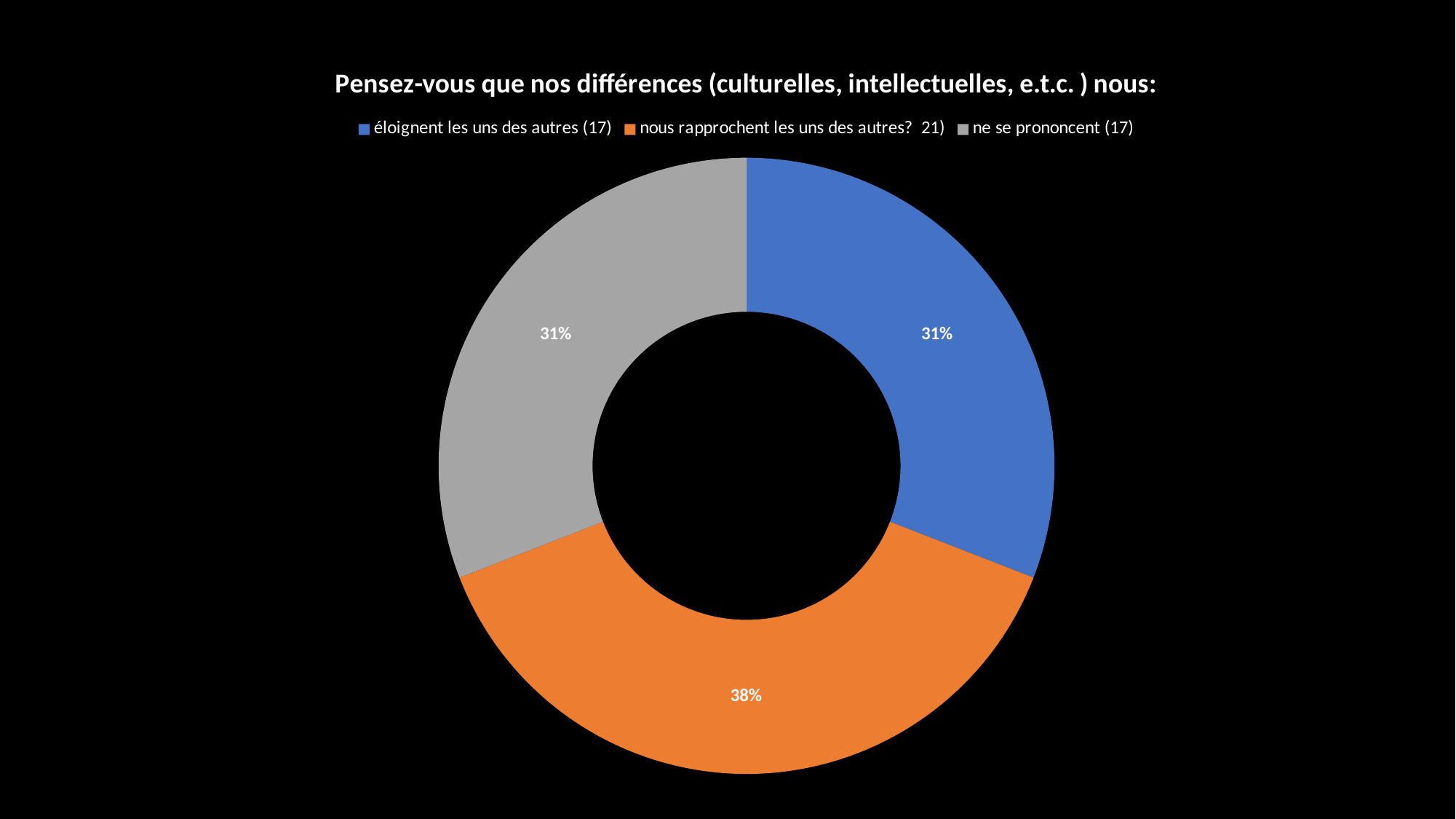
What is the title of the chart? Pensez-vous que nos différences (culturelles, intellectuelles, e.t.c. ) nous: What kind of chart is shown on the slide? Doughnut (pie) chart What percentage share is shown for "nous rapprochent les uns des autres?"? 38% How many entries does the legend list? 3 What colour is the slice for "ne se prononcent"? Grey Which category has the largest share of the chart? nous rapprochent les uns des autres? What is the difference in percentage points between the share for "nous rapprochent les uns des autres?" and the share for "ne se prononcent"? 7 Is the share for "nous rapprochent les uns des autres?" greater or less than 35%? greater What percentage share is shown for "éloignent les uns des autres"? 31% Which is larger: the share for "nous rapprochent les uns des autres?" or the share for "éloignent les uns des autres"? nous rapprochent les uns des autres? How many categories does the chart show? 3 What percentage share is shown for "ne se prononcent"? 31%